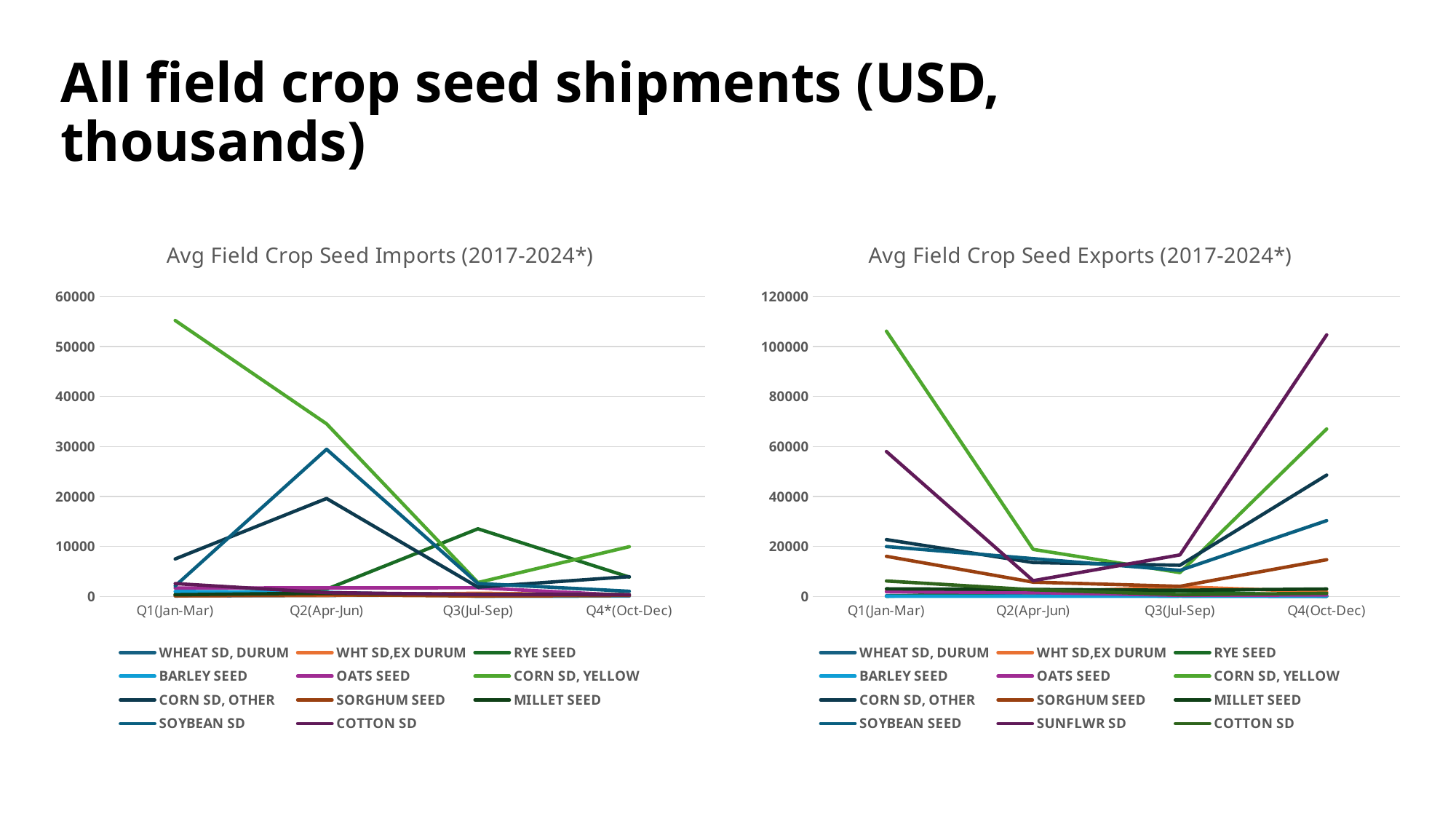
In the Avg Field Crop Seed Exports (2017-2024*) chart, is the value for CORN SD, YELLOW at Q1(Jan-Mar) greater or less than 100000? greater In the Avg Field Crop Seed Exports (2017-2024*) chart, which is larger at Q4(Oct-Dec): SUNFLWR SD or CORN SD, YELLOW? SUNFLWR SD What kind of chart is the Avg Field Crop Seed Imports (2017-2024*) chart? line chart In the Avg Field Crop Seed Exports (2017-2024*) chart, which series has the highest value at Q4(Oct-Dec)? SUNFLWR SD How many quarters are shown on the x axis of the Avg Field Crop Seed Exports (2017-2024*) chart? 4 In the Avg Field Crop Seed Imports (2017-2024*) chart, is the value for CORN SD, YELLOW at Q1(Jan-Mar) greater or less than 50000? greater How many series does the legend of the Avg Field Crop Seed Exports (2017-2024*) chart list? 12 In the Avg Field Crop Seed Imports (2017-2024*) chart, which series has the highest value at Q1(Jan-Mar)? CORN SD, YELLOW In the Avg Field Crop Seed Imports (2017-2024*) chart, is the value for SOYBEAN SD at Q2(Apr-Jun) greater or less than 20000? greater In the Avg Field Crop Seed Imports (2017-2024*) chart, does the CORN SD, YELLOW line rise or fall from Q1(Jan-Mar) to Q3(Jul-Sep)? fall How many series does the legend of the Avg Field Crop Seed Imports (2017-2024*) chart list? 11